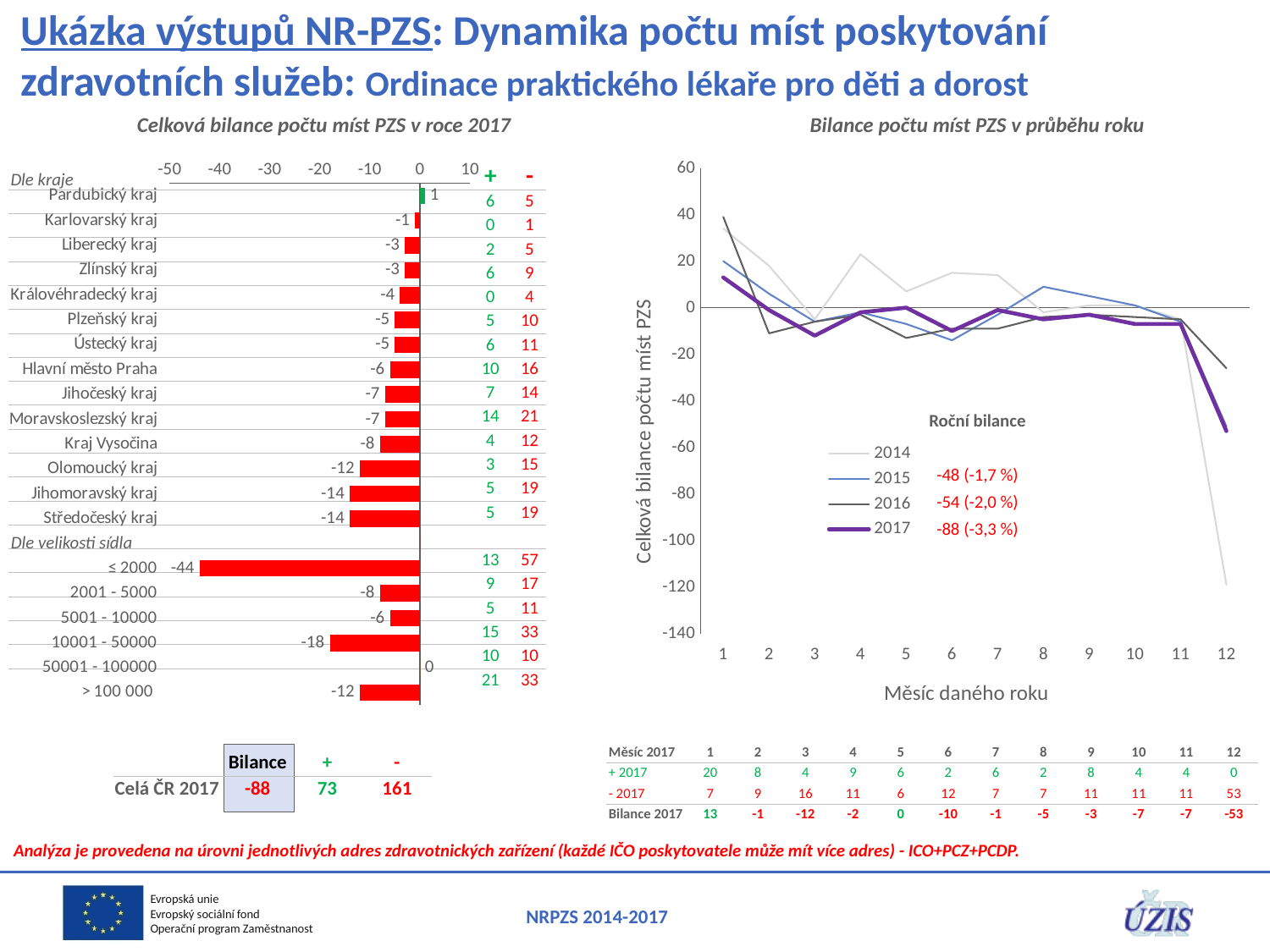
In the left chart 'Celková bilance počtu míst PZS v roce 2017', what is the value for Středočeský kraj? -14 How many months are shown on the x axis of the right chart 'Bilance počtu míst PZS v průběhu roku'? 12 In the right chart 'Bilance počtu míst PZS v průběhu roku', is the value of the 2014 series in month 12 greater or less than -100? less In the left chart 'Celková bilance počtu míst PZS v roce 2017', what is the value for the settlement size category ≤ 2000? -44 What kind of chart is the right chart titled 'Bilance počtu míst PZS v průběhu roku'? line chart In the left chart 'Celková bilance počtu míst PZS v roce 2017', which settlement size category has the lowest value? ≤ 2000 What kind of chart is the left chart titled 'Celková bilance počtu míst PZS v roce 2017'? bar chart In the left chart 'Celková bilance počtu míst PZS v roce 2017', which has the larger value, Hlavní město Praha or Jihočeský kraj? Hlavní město Praha How many series does the legend of the right chart 'Bilance počtu míst PZS v průběhu roku' list? 4 In the left chart 'Celková bilance počtu míst PZS v roce 2017', what is the difference between the values for Olomoucký kraj and Kraj Vysočina? 4 In the right chart 'Bilance počtu míst PZS v průběhu roku', what is the value of the 2017 series in month 12? -53 In the left chart 'Celková bilance počtu míst PZS v roce 2017', which region (kraj) has the highest value? Pardubický kraj